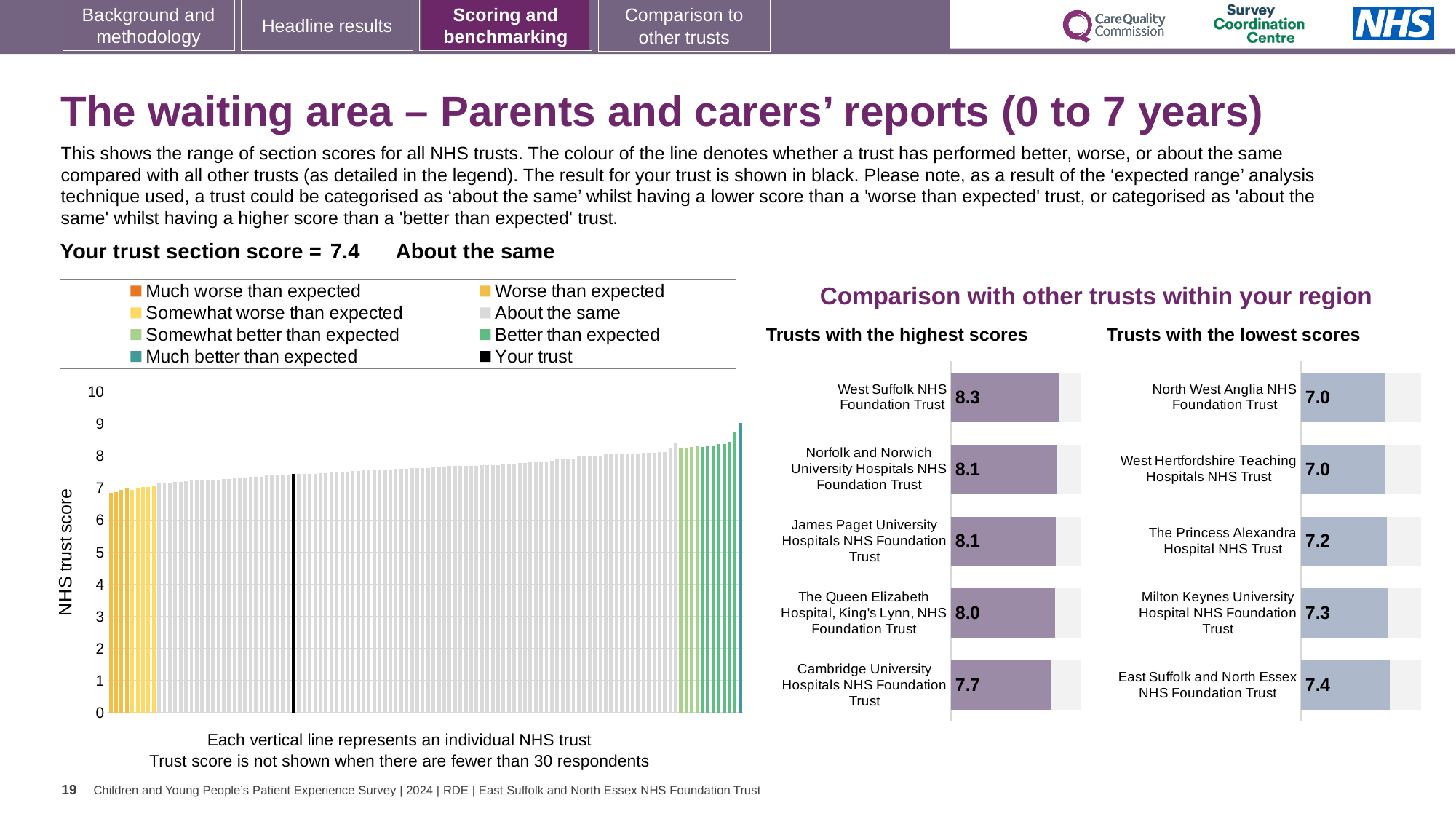
In the 'Trusts with the lowest scores' chart, what is the score for The Princess Alexandra Hospital NHS Trust? 7.2 In the main chart on the left, is the value of the black bar (your trust) greater or less than 8? less In the main chart on the left, do the trust scores rise or fall from left to right? rise In the 'Trusts with the highest scores' chart, which trust has the highest score? West Suffolk NHS Foundation Trust How many entries does the legend above the main chart on the left list? 8 In the main chart on the left, what is the label on the vertical axis? NHS trust score In the 'Trusts with the highest scores' chart, what is the score for Cambridge University Hospitals NHS Foundation Trust? 7.7 In the 'Trusts with the lowest scores' chart, which trust has the highest score? East Suffolk and North Essex NHS Foundation Trust In the 'Trusts with the highest scores' chart, what is the difference between the scores of West Suffolk NHS Foundation Trust and Cambridge University Hospitals NHS Foundation Trust? 0.6 In the 'Trusts with the lowest scores' chart, which has the larger score: The Princess Alexandra Hospital NHS Trust or Milton Keynes University Hospital NHS Foundation Trust? Milton Keynes University Hospital NHS Foundation Trust In the main chart on the left, what kind of chart is used to show the range of section scores for all NHS trusts? bar chart How many trusts are shown in the 'Trusts with the lowest scores' chart? 5